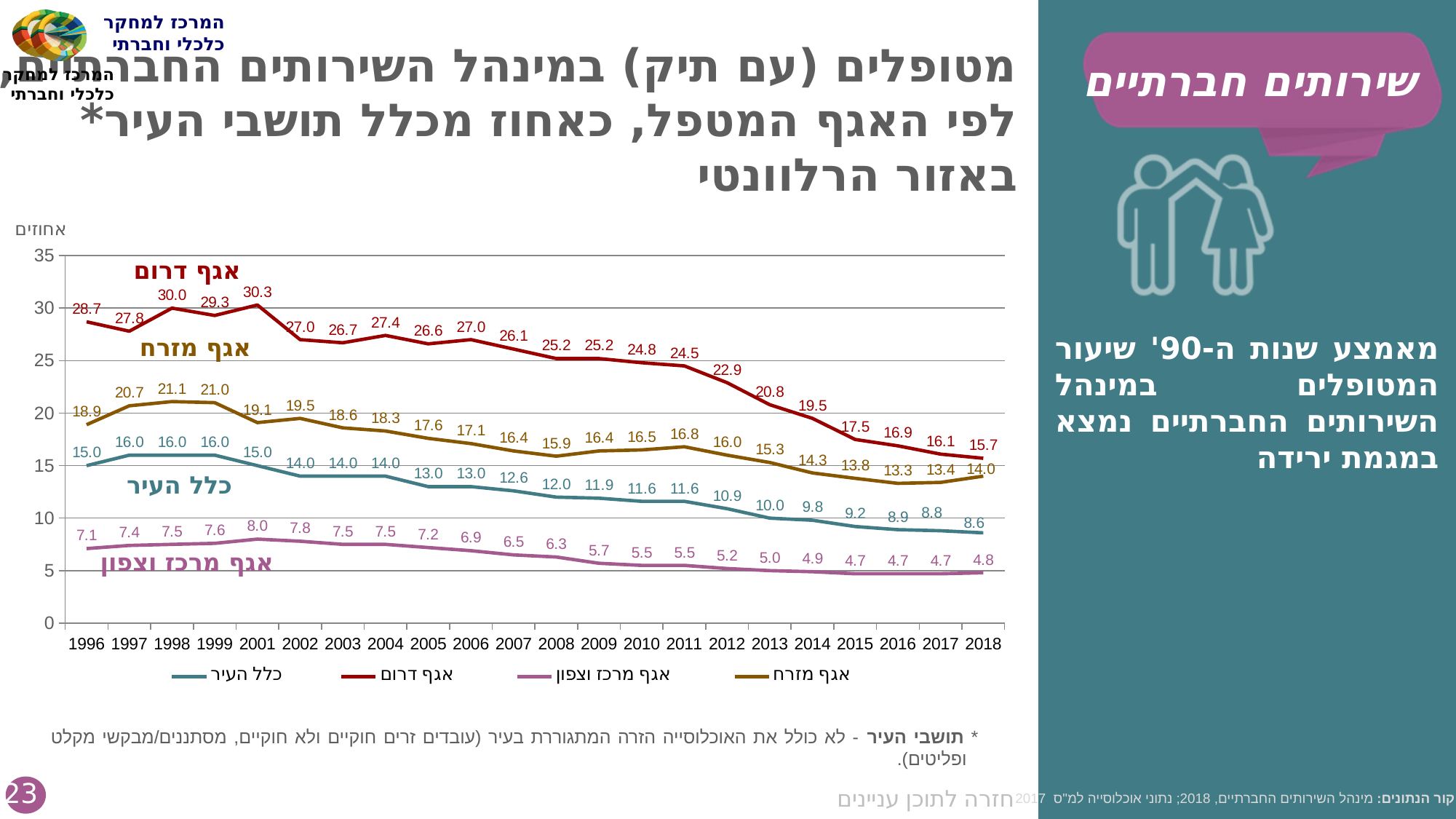
What is the difference between the אגף דרום value in 1996 and in 2018? 13.0 In which year does אגף דרום reach its highest value? 2001 Does the כלל העיר series generally rise or fall from 1996 to 2018? fall What is the value for כלל העיר in 2018? 8.6 What is the value for אגף דרום in 2001? 30.3 Which series has the higher value in 2010, אגף מזרח or כלל העיר? אגף מזרח What is the value for אגף מזרח in 1998? 21.1 What is the value for אגף מרכז וצפון in 2001? 8.0 In which year does כלל העיר reach its lowest value? 2018 How many series does the legend list? 4 What type of chart is shown on the slide? line chart How many years are shown on the x axis? 22